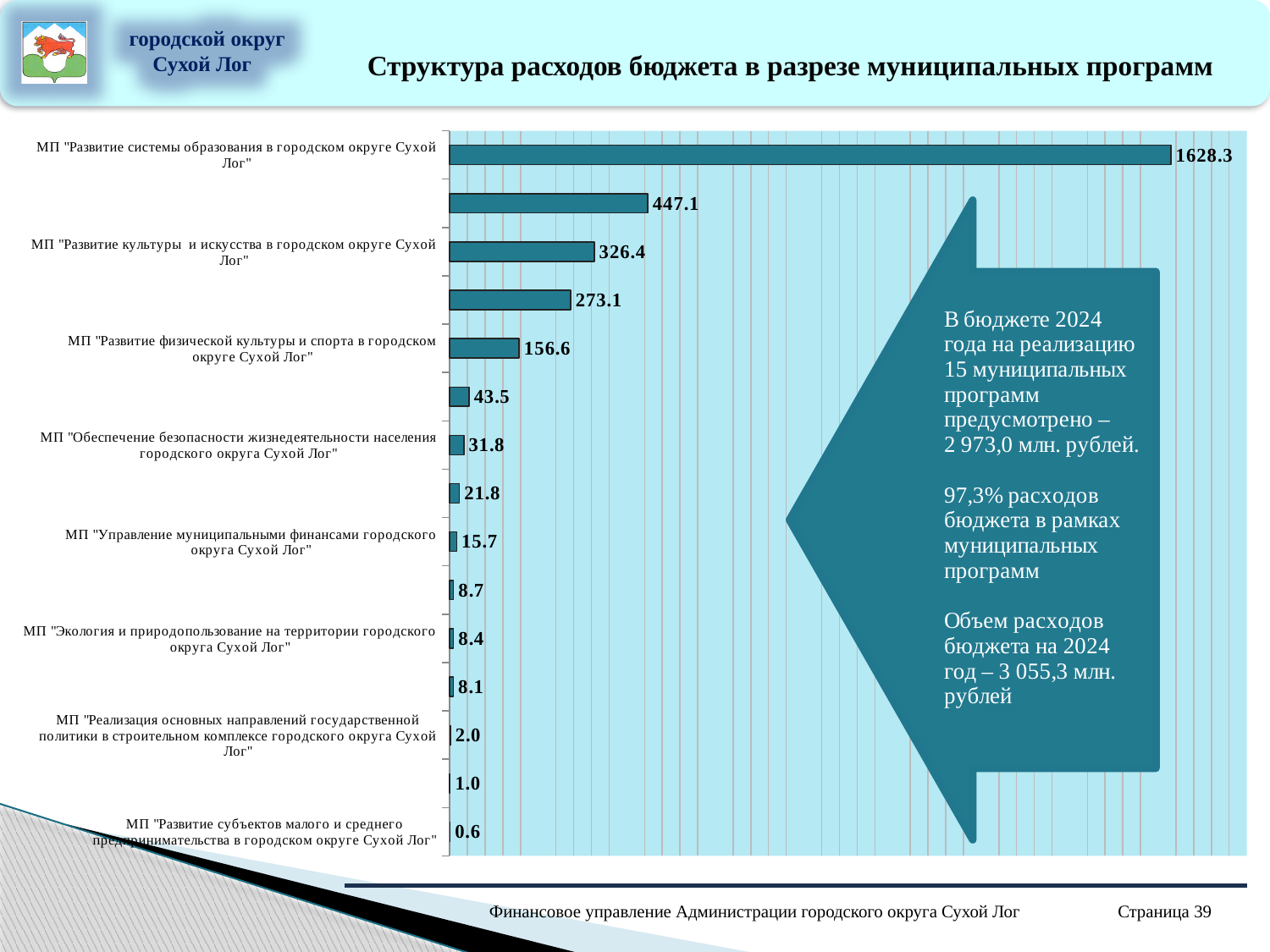
What is the value for МП "Обеспечение безопасности жизнедеятельности населения городского округа Сухой Лог"? 31.8 What is the difference between the value for МП "Развитие системы образования" and the value for МП "Развитие культуры и искусства"? 1301.9 What is the value for МП "Развитие физической культуры и спорта в городском округе Сухой Лог"? 156.6 What is the value for МП "Развитие системы образования в городском округе Сухой Лог"? 1628.3 What is the value for МП "Экология и природопользование на территории городского округа Сухой Лог"? 8.4 What kind of chart is shown on the slide? Bar chart Which program has the highest value in the chart? МП "Развитие системы образования в городском округе Сухой Лог" How many bars are plotted in the chart? 15 What is the value for МП "Развитие субъектов малого и среднего предпринимательства в городском округе Сухой Лог"? 0.6 Which is larger: the value for МП "Развитие культуры и искусства" or the value for МП "Развитие физической культуры и спорта"? МП "Развитие культуры и искусства" Which program has the lowest value in the chart? МП "Развитие субъектов малого и среднего предпринимательства в городском округе Сухой Лог" What is the value for МП "Развитие культуры и искусства в городском округе Сухой Лог"? 326.4